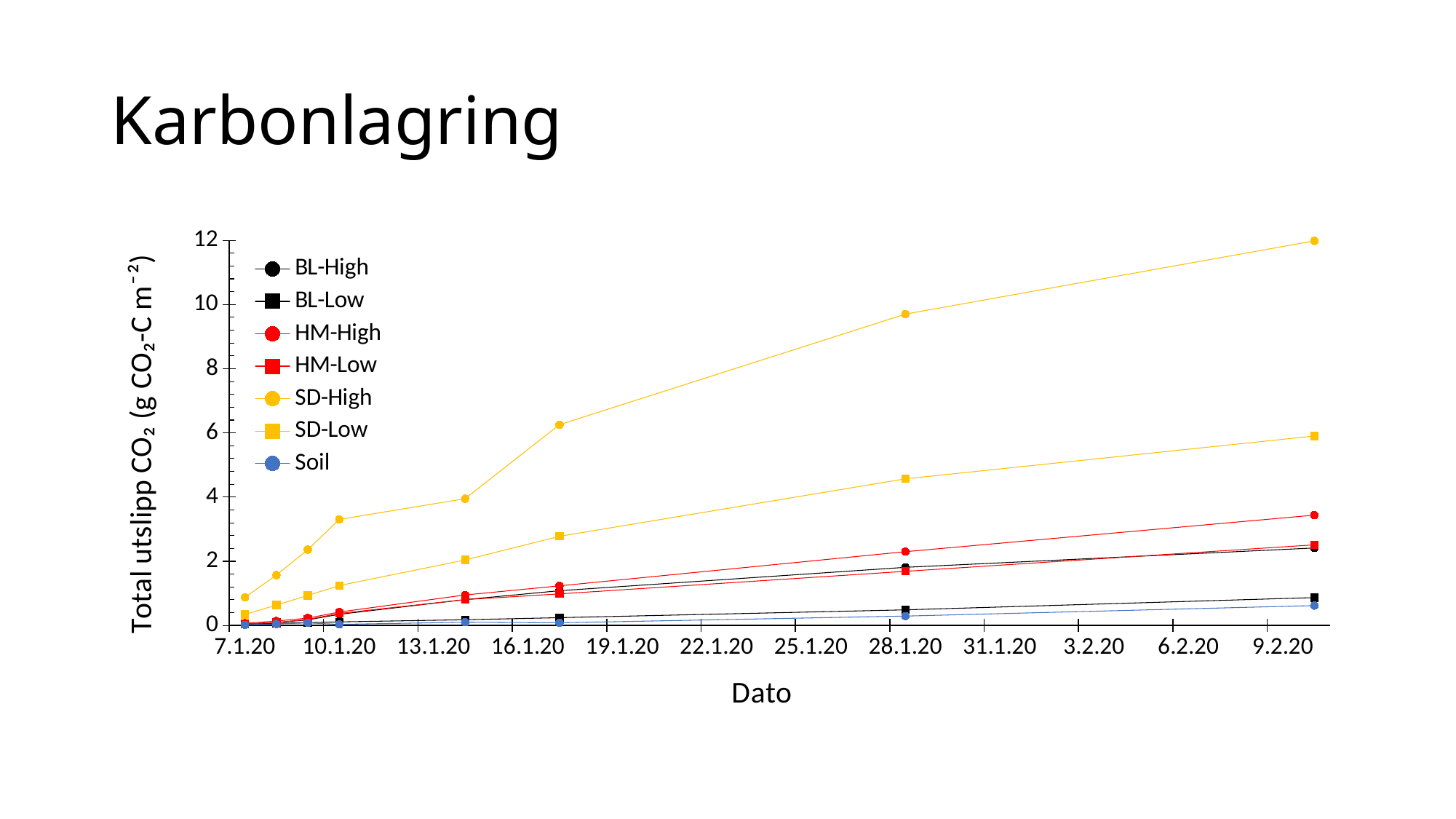
At 28.1.20, which is larger: Soil or SD-Low? SD-Low How many series does the legend list? 7 Is the value for Soil at 9.2.20 greater or less than 2? less Which series has the highest value at 9.2.20? SD-High Is the value for SD-High at 28.1.20 greater or less than 8? greater Is the value for HM-High at 9.2.20 greater or less than 4? less What is the label of the x axis? Dato Which series has the lowest value at 9.2.20? Soil What kind of chart is shown on the slide? line chart At 9.2.20, which is larger: SD-High or SD-Low? SD-High Do the values for SD-High rise or fall along the x axis? rise